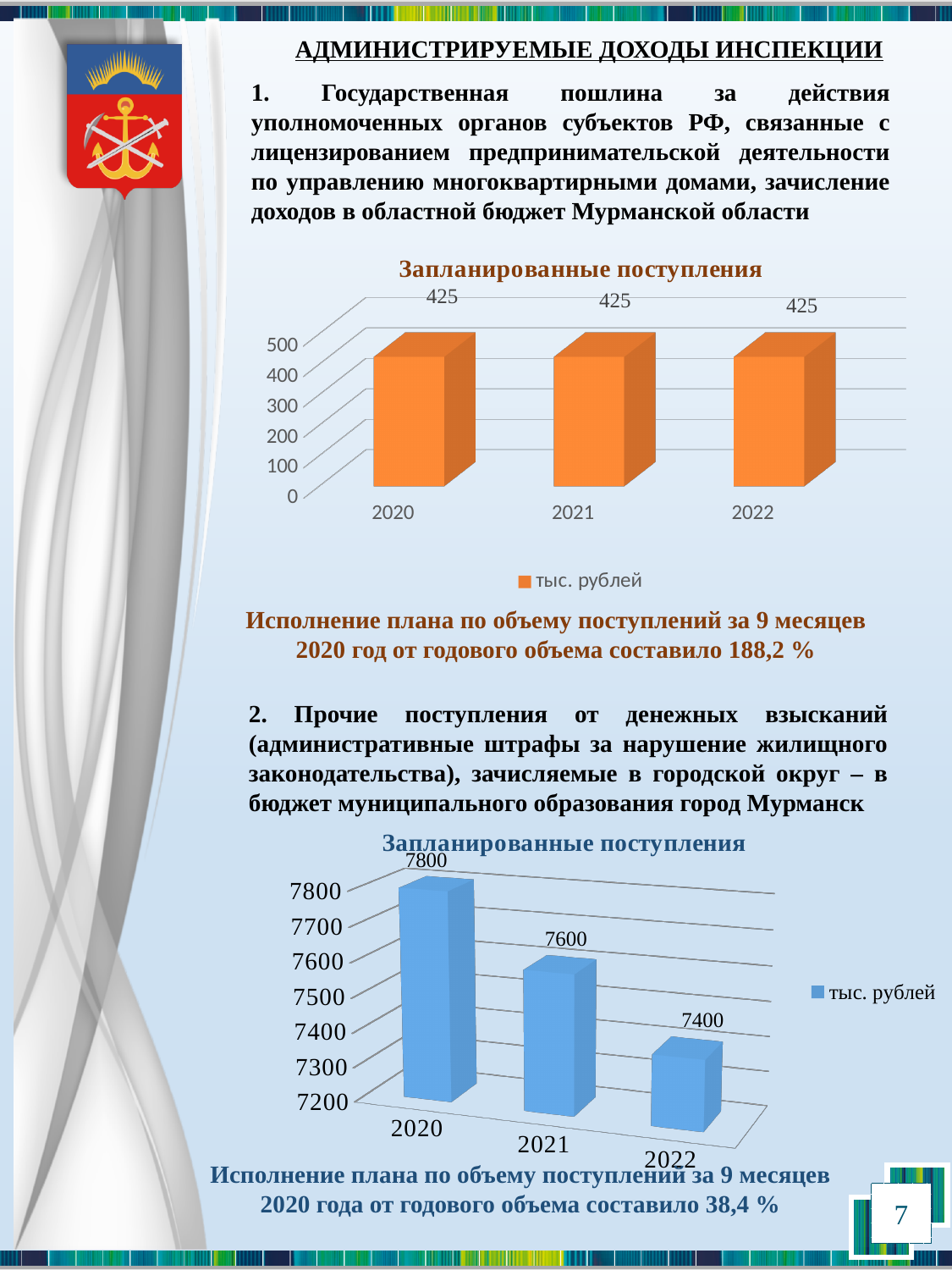
In the bottom chart, which year has the lowest value? 2022 In the bottom chart, what is the value for 2022? 7400 In the bottom chart, which year has the highest value? 2020 In the bottom chart, what is the difference between the values for 2020 and 2022? 400 How many years are shown in the top chart? 3 In the bottom chart, do the values rise or fall from 2020 to 2022? fall In the bottom chart, what is the value for 2020? 7800 In the top chart, is the value for 2022 greater or less than 400? greater In the bottom chart, which is larger, the value for 2021 or the value for 2022? 2021 What kind of chart is the bottom chart? bar chart What is the legend entry of the top chart? тыс. рублей In the top chart, what is the value for 2021? 425